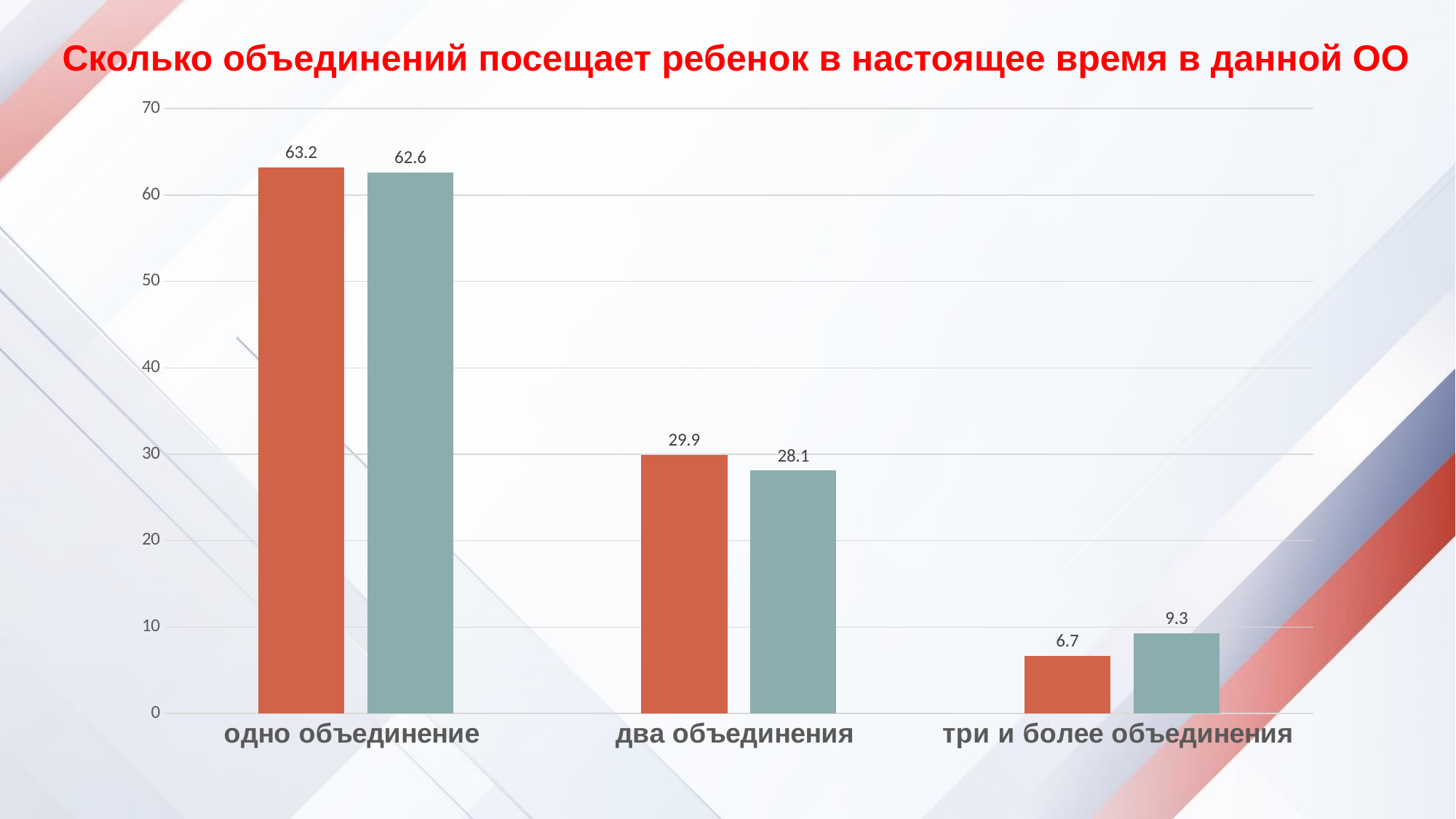
For "три и более объединения", which bar is larger, the orange or the teal one? teal What is the value of the orange bar for "одно объединение"? 63.2 What kind of chart is shown on the slide? bar chart Which category has the lowest orange bar? три и более объединения Is the value of the teal bar for "два объединения" greater or less than 30? less How many categories are shown on the x axis? 3 What is the value of the orange bar for "два объединения"? 29.9 Do the orange bars rise or fall from left to right along the x axis? fall What is the value of the teal bar for "три и более объединения"? 9.3 What is the value of the teal bar for "одно объединение"? 62.6 What is the difference between the orange and teal bars for "два объединения"? 1.8 Which category has the highest teal bar? одно объединение